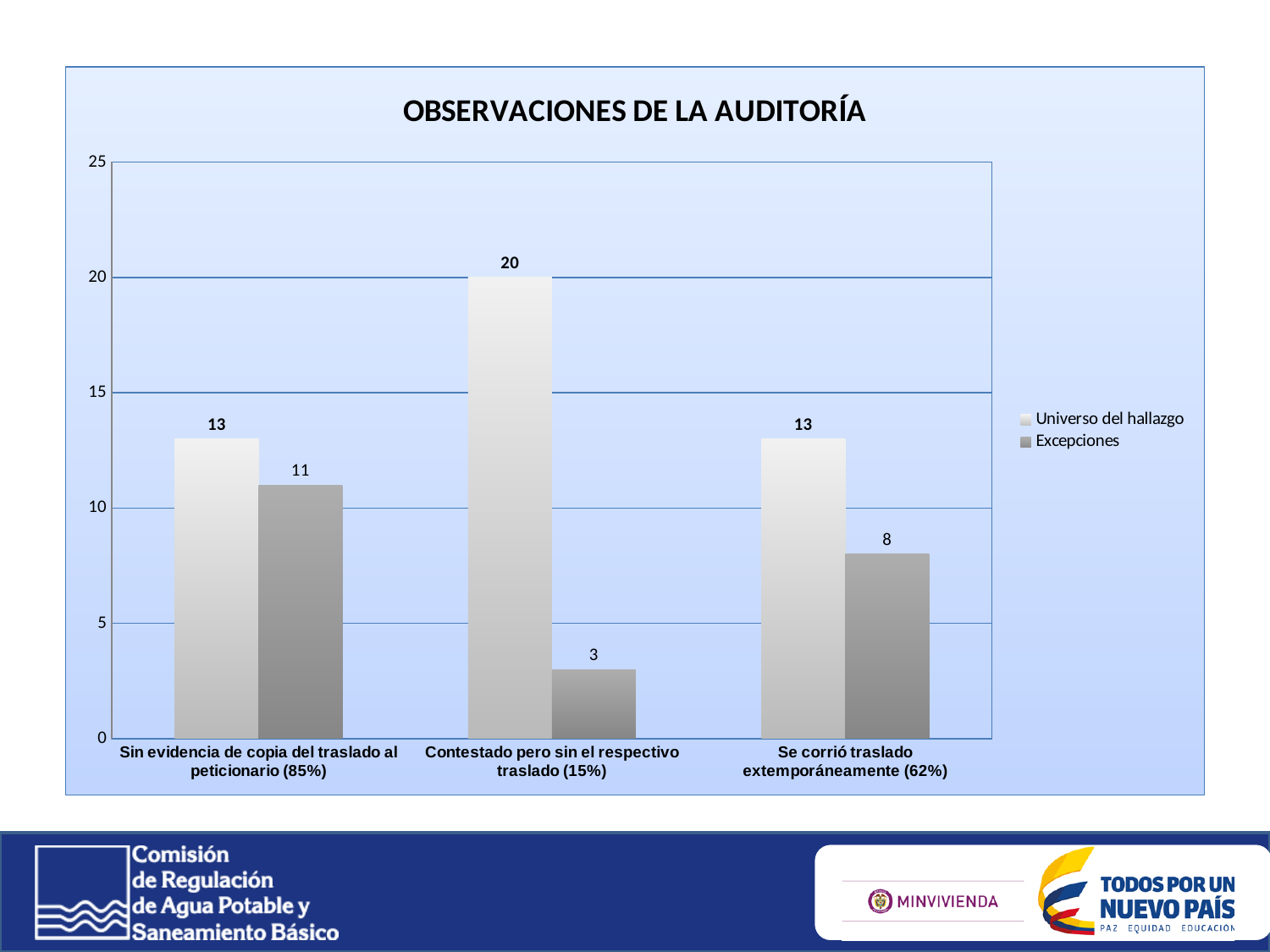
What is the title of the chart? OBSERVACIONES DE LA AUDITORÍA How many series does the legend list? 2 Which category has the highest Universo del hallazgo value? Contestado pero sin el respectivo traslado (15%) What is the value of Universo del hallazgo for 'Contestado pero sin el respectivo traslado (15%)'? 20 What is the value of Excepciones for 'Sin evidencia de copia del traslado al peticionario (85%)'? 11 Is the Excepciones value for 'Se corrió traslado extemporáneamente (62%)' greater or less than 10? less Which is larger for 'Sin evidencia de copia del traslado al peticionario (85%)': Universo del hallazgo or Excepciones? Universo del hallazgo What is the difference between Universo del hallazgo and Excepciones for 'Contestado pero sin el respectivo traslado (15%)'? 17 What kind of chart is shown? bar chart How many categories are shown on the x axis? 3 What is the value of Excepciones for 'Se corrió traslado extemporáneamente (62%)'? 8 Which category has the lowest Excepciones value? Contestado pero sin el respectivo traslado (15%)